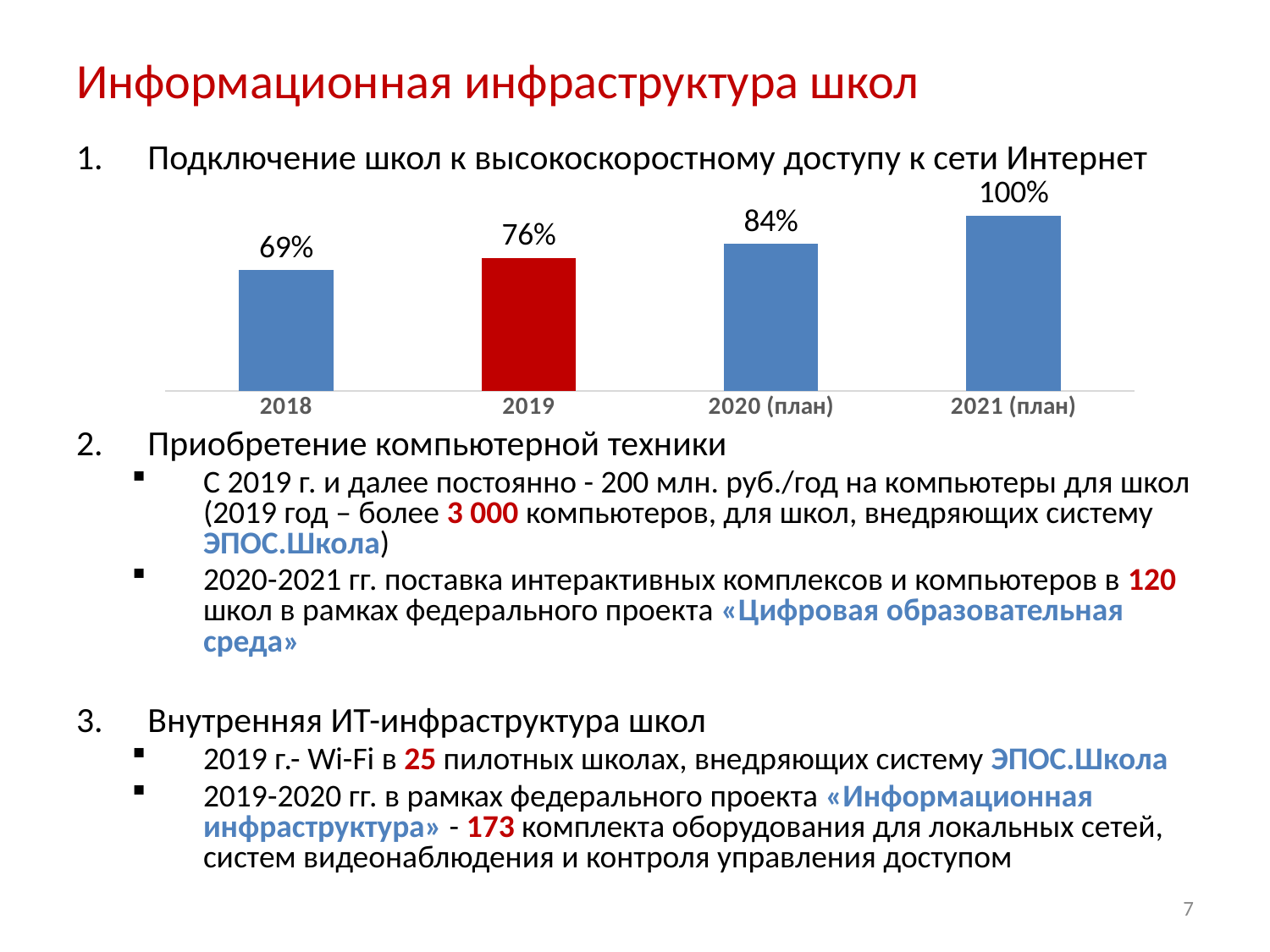
What is the value for 2020 (план)? 84% What is the value for 2019? 76% Do the values rise or fall from 2018 to 2021 (план)? rise Which is larger, the value for 2019 or the value for 2020 (план)? 2020 (план) What kind of chart is shown on the slide? bar chart What is the value for 2021 (план)? 100% Which category has the highest value? 2021 (план) How many categories are shown on the x axis of the chart? 4 What is the difference between the values for 2021 (план) and 2020 (план)? 16% What is the difference between the values for 2019 and 2018? 7% What is the value for 2018? 69% Which category has the lowest value? 2018